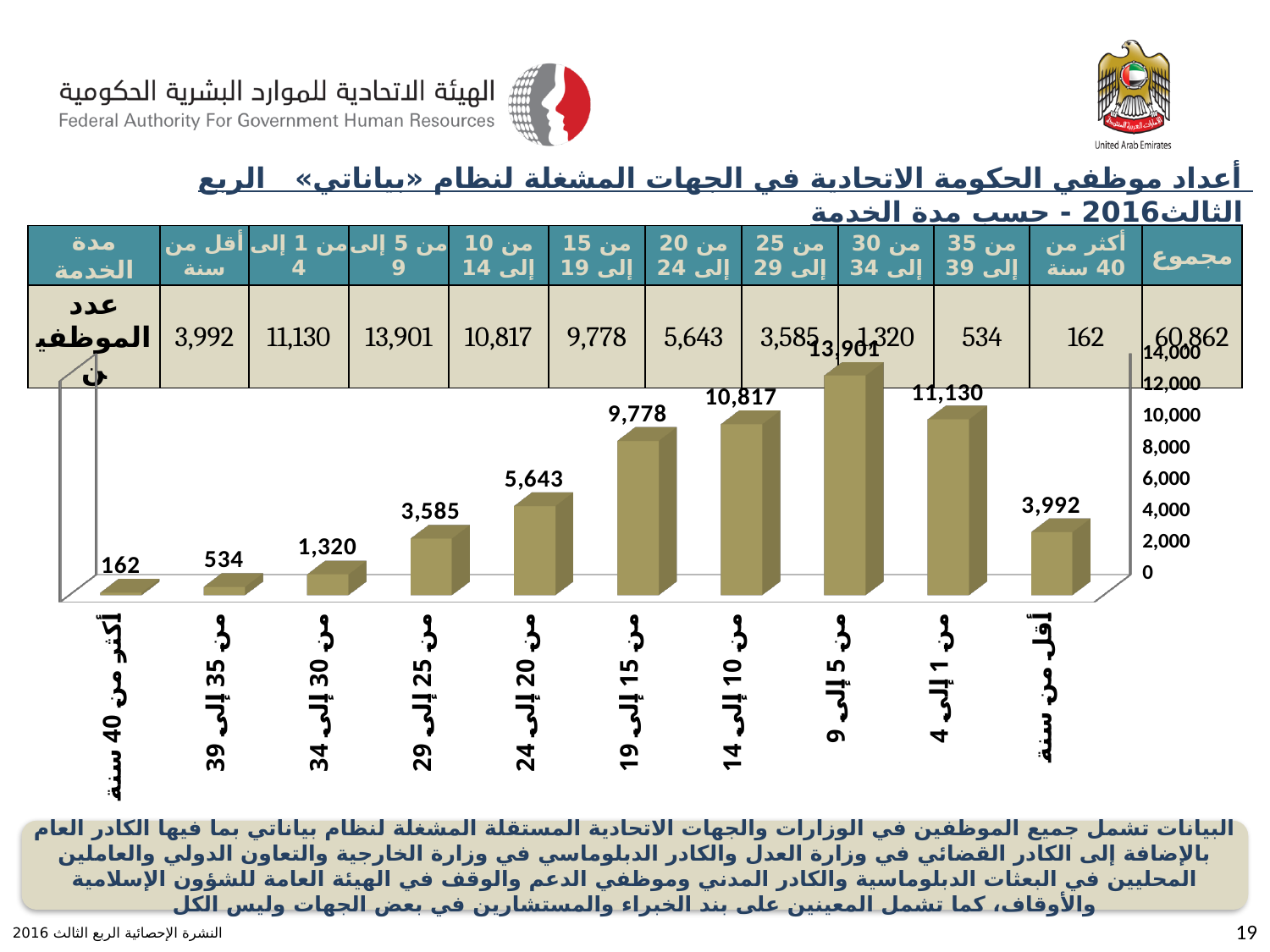
What is the number of employees for the category "من 20 إلى 24" (20 to 24 years)? 5,643 Which service-length category has the lowest number of employees? أكثر من 40 سنة What is the number of employees for the category "أقل من سنة" (less than one year)? 3,992 Which has more employees: "من 15 إلى 19" or "من 25 إلى 29"? من 15 إلى 19 What is the number of employees for the category "من 5 إلى 9" (5 to 9 years)? 13,901 Is the value for "من 30 إلى 34" greater or less than 2,000? less What type of chart is shown on the slide? bar chart What is the difference between the number of employees in "من 1 إلى 4" and "من 10 إلى 14"? 313 How many service-length categories are plotted in the chart? 10 What is the total number of employees (مجموع) shown in the table above the chart? 60,862 What is the number of employees for the category "أكثر من 40 سنة" (more than 40 years)? 162 Which service-length category has the highest number of employees? من 5 إلى 9